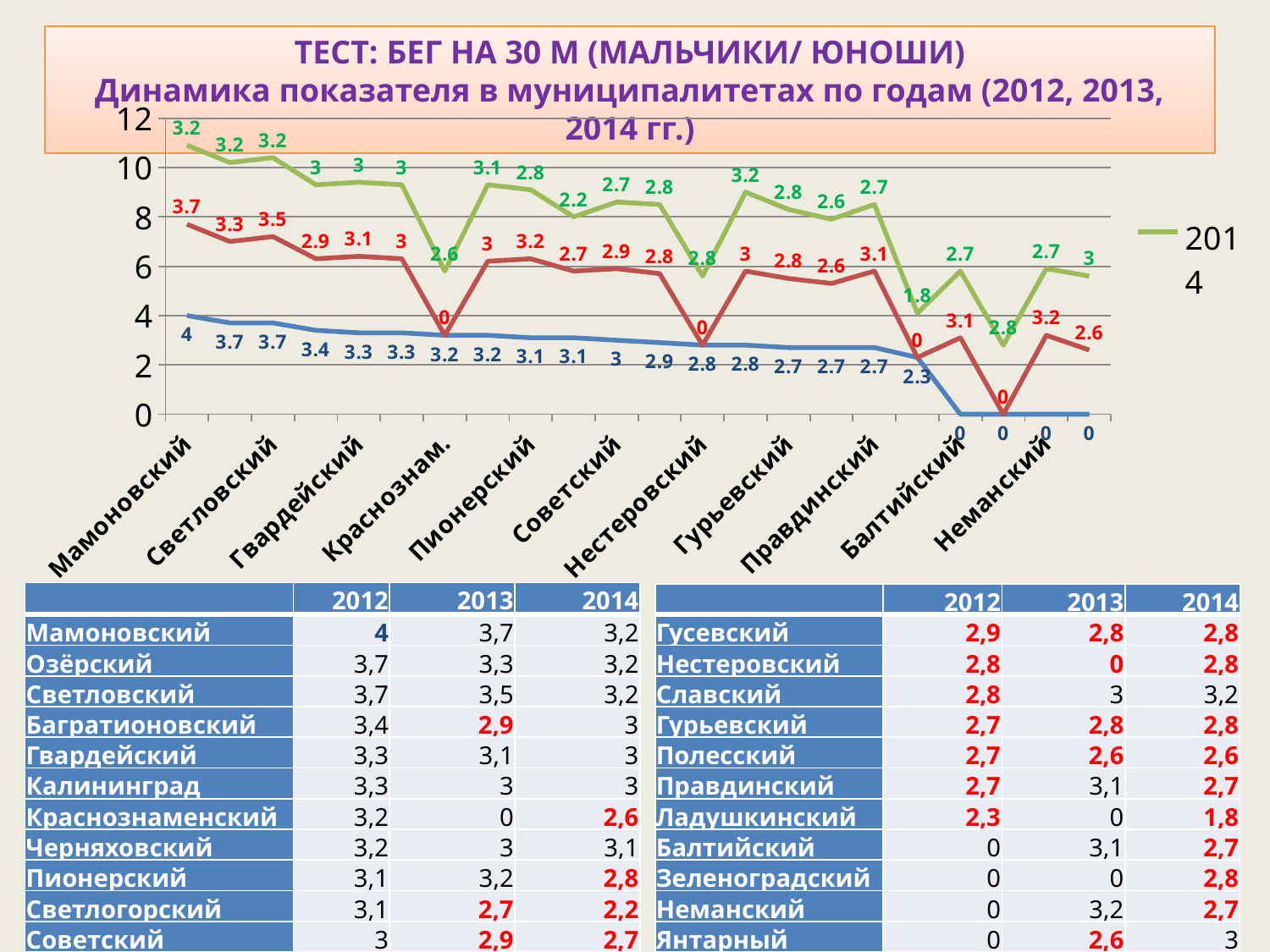
At Мамоновский, which is larger: the red line value or the green line value? red line What is the value of the green (2014) line at Мамоновский? 3.2 What is the value of the blue line at Неманский? 0 What is the value of the green (2014) line at Балтийский? 2.7 How many data points does each line in the chart have? 22 Does the blue line generally rise or fall from left to right along the x axis? fall What is the value of the red line at Неманский? 3.2 What is the value of the blue line at Мамоновский? 4 What is the lowest data label shown on the green (2014) line? 1.8 At which category does the blue line reach its highest value? Мамоновский What type of chart is shown on the slide? line chart What is the difference between the blue line values at Мамоновский and Светловский? 0.3